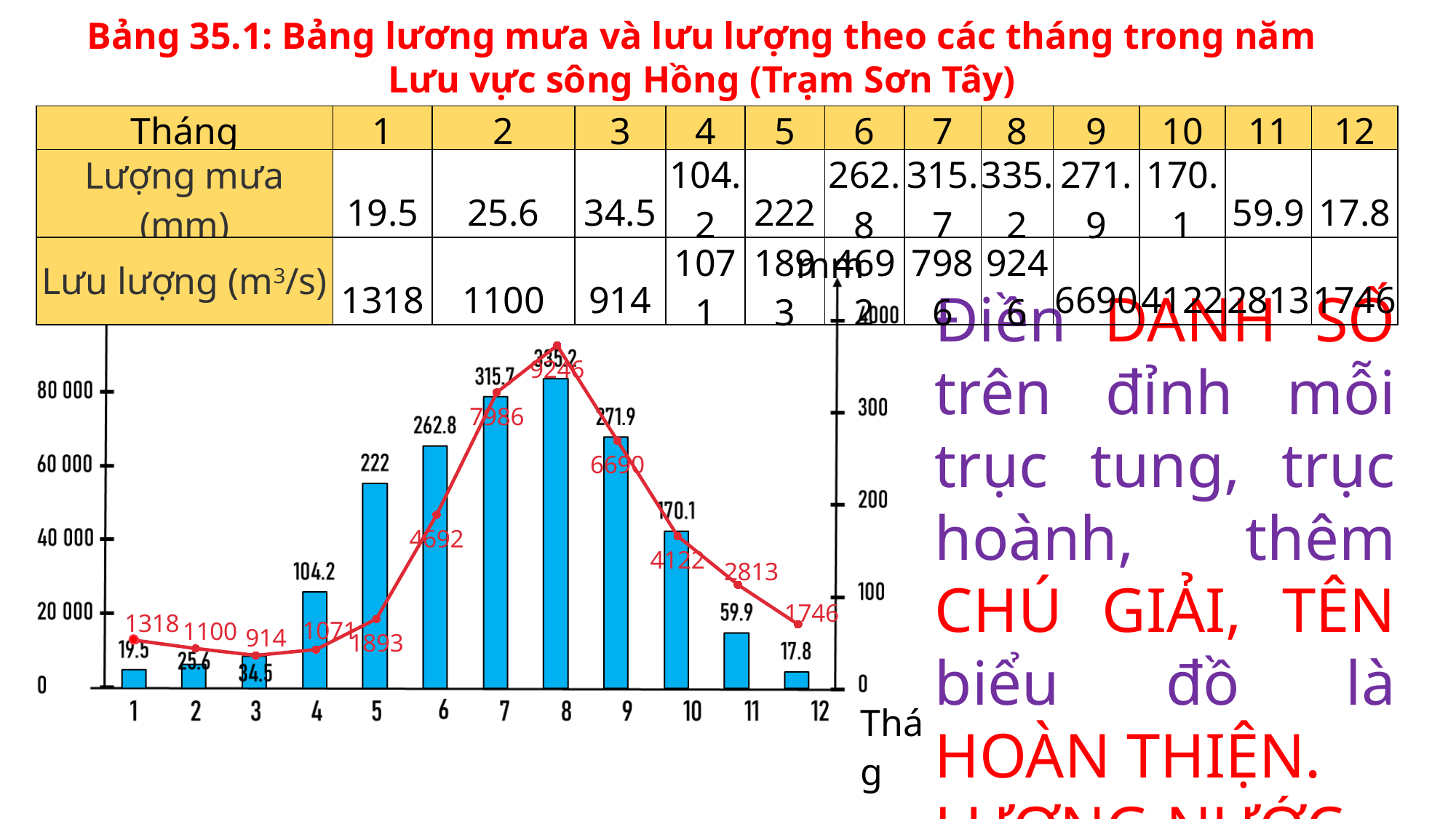
What is the rainfall value shown on the bar for month 5? 222 Which month has the highest bar (rainfall)? 8 What is the difference between the discharge values for month 8 and month 9? 2556 Which month has the lowest bar (rainfall)? 12 Which month has the lowest point on the discharge line? 3 What is the rainfall value shown on the bar for month 8? 335.2 What is the discharge value shown on the line for month 7? 7986 How many months are plotted along the x axis of the chart? 12 What kind of chart is shown on the slide? combined bar and line chart What is the difference between the rainfall values for month 8 and month 7? 19.5 Do the rainfall bars rise or fall from month 8 to month 12? fall Which is larger, the rainfall bar for month 6 or for month 9? month 9